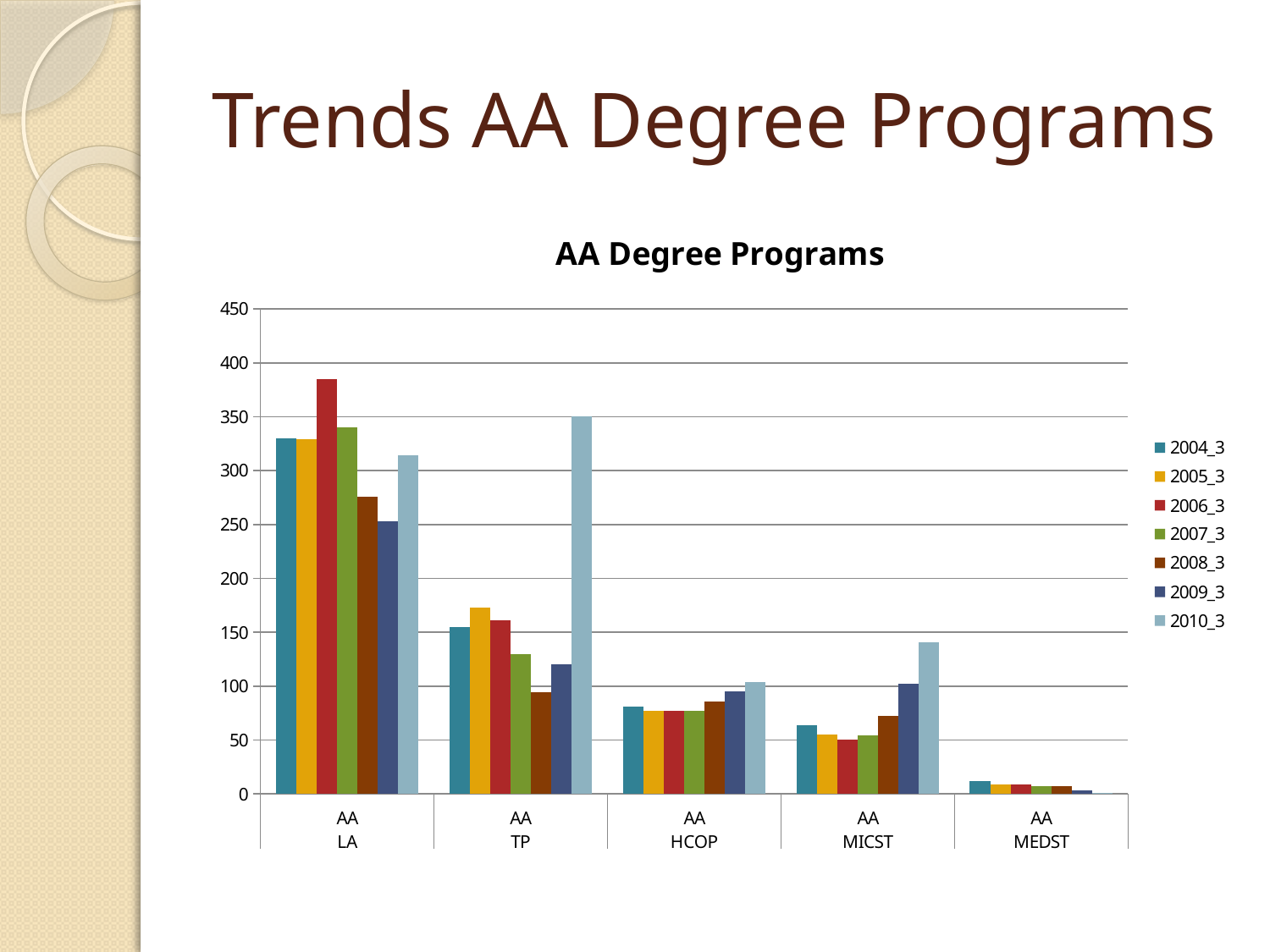
Is the 2006_3 value for AA LA greater or less than 350? greater Which series has the highest value for AA LA? 2006_3 What is the title of the chart? AA Degree Programs Is the 2010_3 value for AA MICST greater or less than 100? greater What kind of chart is shown on the slide? bar chart How many degree program categories are shown on the x axis? 5 Which category has the lowest values across all series? AA MEDST Which series has the highest value for AA MICST? 2010_3 For AA MICST, do the values rise or fall from 2007_3 to 2010_3? rise How many series does the legend list? 7 Which is larger for AA TP: the 2005_3 value or the 2008_3 value? 2005_3 Which series has the lowest value for AA TP? 2008_3